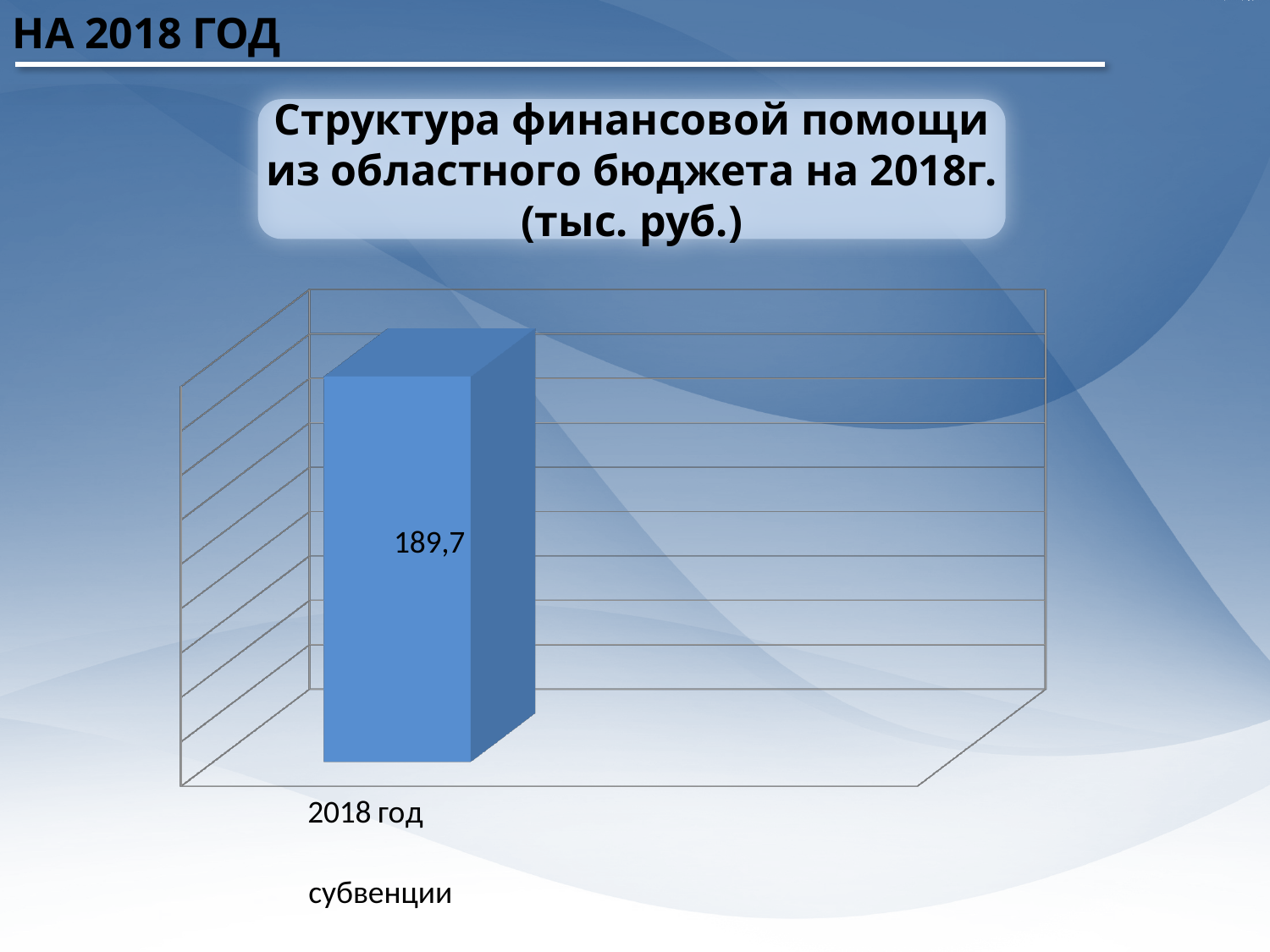
What kind of chart is shown on the slide? bar chart What series name appears in the chart's legend? субвенции What is the category label on the x axis of the chart? 2018 год How many series does the chart's legend list? 1 What is the value shown for субвенции in 2018 год? 189,7 How many bars are plotted in the chart? 1 What value is printed on the bar in the chart? 189,7 How many categories are shown on the x axis of the chart? 1